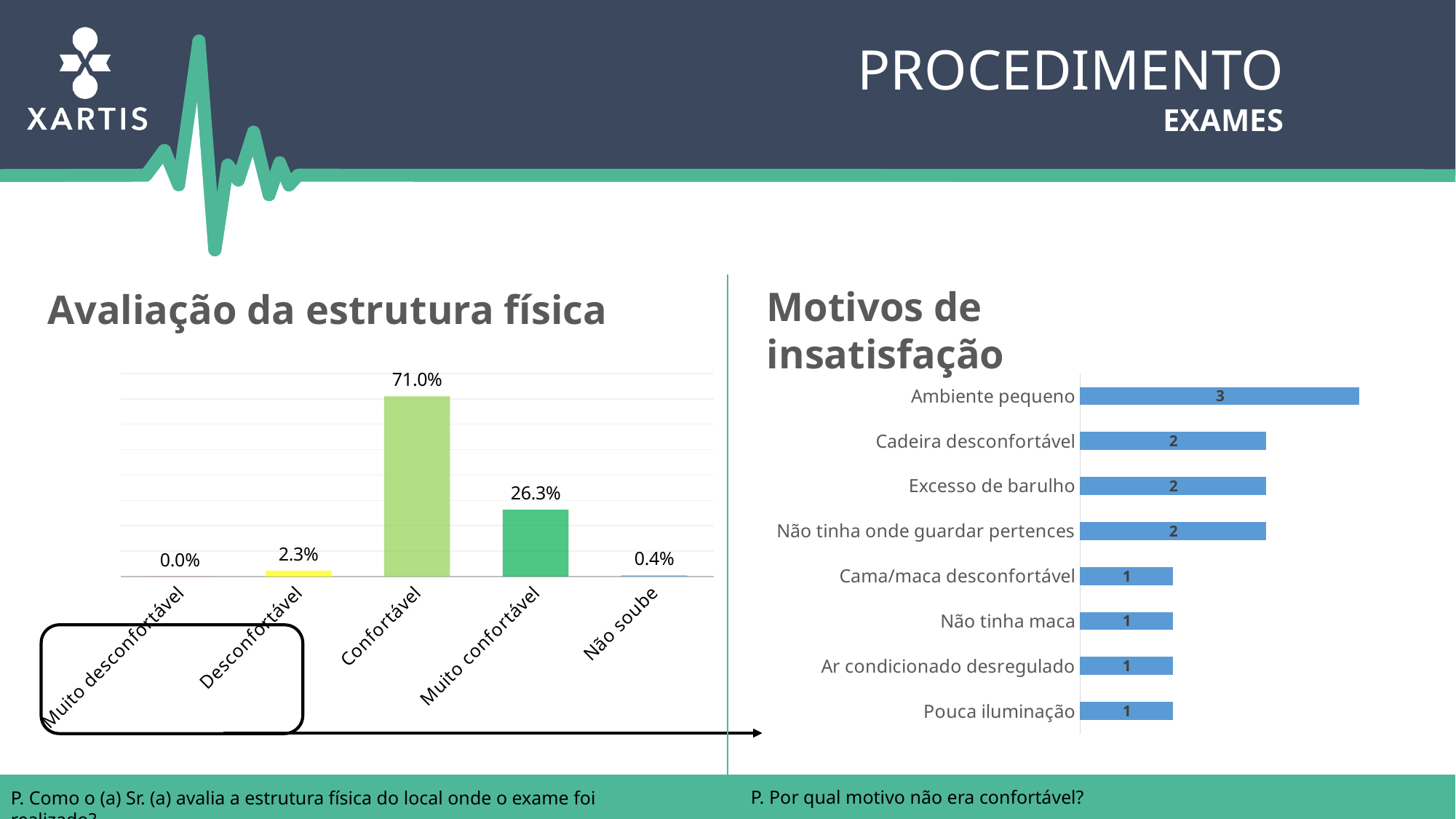
In the 'Motivos de insatisfação' chart, which category has the highest value? Ambiente pequeno In the 'Avaliação da estrutura física' chart, which category has the highest value? Confortável In the 'Motivos de insatisfação' chart, what is the value for Ambiente pequeno? 3 What kind of chart is the 'Motivos de insatisfação' chart? Bar chart In the 'Avaliação da estrutura física' chart, what is the difference between Confortável and Muito confortável? 44.7% In the 'Avaliação da estrutura física' chart, which category has the lowest value? Muito desconfortável In the 'Avaliação da estrutura física' chart, how many categories are shown on the x axis? 5 In the 'Avaliação da estrutura física' chart, what is the value for Confortável? 71.0% In the 'Avaliação da estrutura física' chart, what is the value for Muito confortável? 26.3% In the 'Motivos de insatisfação' chart, how many categories are listed? 8 In the 'Motivos de insatisfação' chart, what is the value for Cama/maca desconfortável? 1 In the 'Avaliação da estrutura física' chart, what is the value for Desconfortável? 2.3%